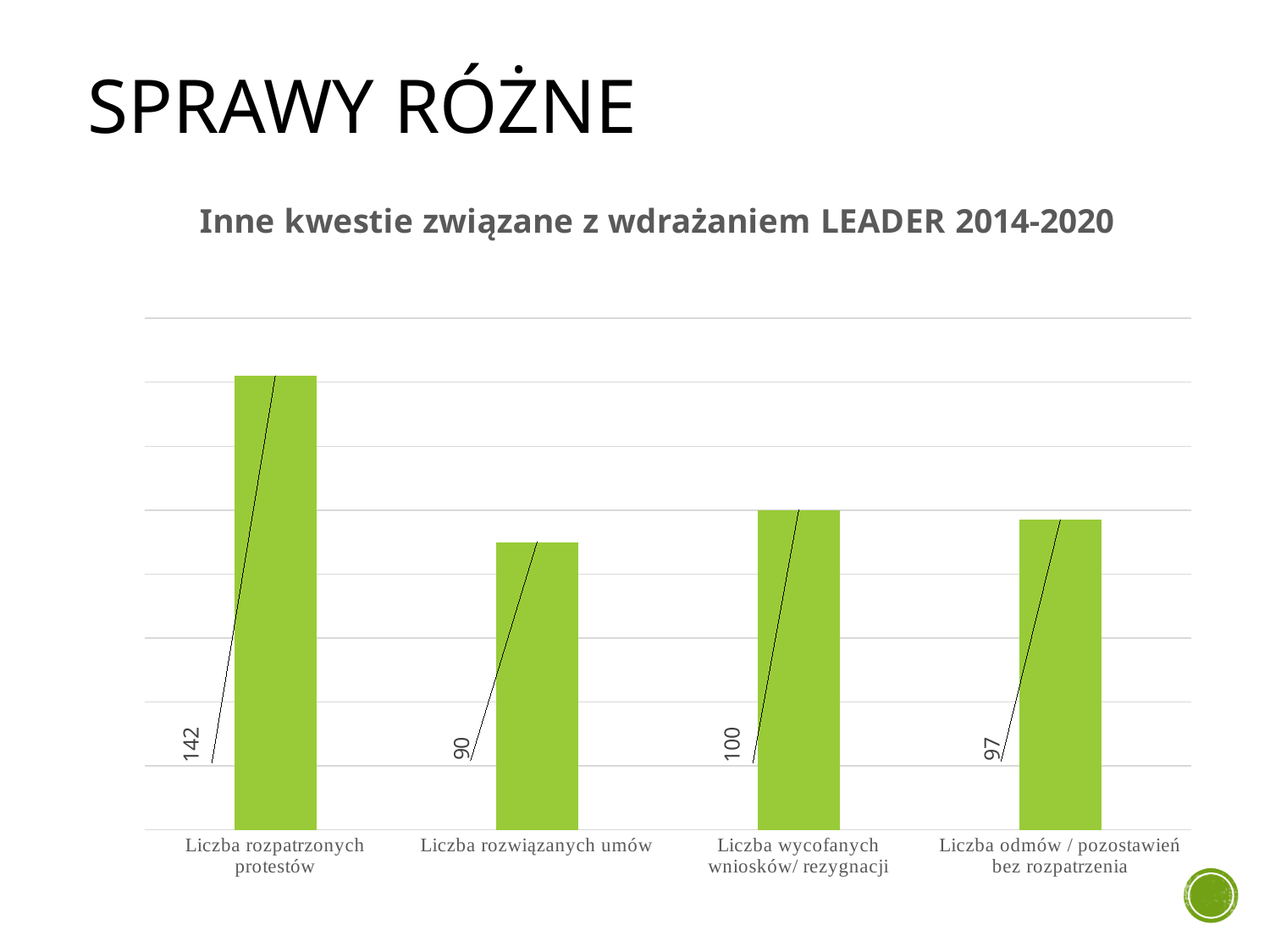
What is the value for "Liczba odmów / pozostawień bez rozpatrzenia"? 97 What is the title of the chart? Inne kwestie związane z wdrażaniem LEADER 2014-2020 What is the difference between the values for "Liczba wycofanych wniosków/ rezygnacji" and "Liczba odmów / pozostawień bez rozpatrzenia"? 3 What kind of chart is shown on the slide? Bar chart What is the value for "Liczba rozpatrzonych protestów"? 142 What is the value for "Liczba rozwiązanych umów"? 90 How many categories are shown in the chart? 4 Which category has the highest value? Liczba rozpatrzonych protestów What is the value for "Liczba wycofanych wniosków/ rezygnacji"? 100 Which is larger: the value for "Liczba wycofanych wniosków/ rezygnacji" or the value for "Liczba rozwiązanych umów"? Liczba wycofanych wniosków/ rezygnacji Which category has the lowest value? Liczba rozwiązanych umów What is the difference between the values for "Liczba rozpatrzonych protestów" and "Liczba rozwiązanych umów"? 52